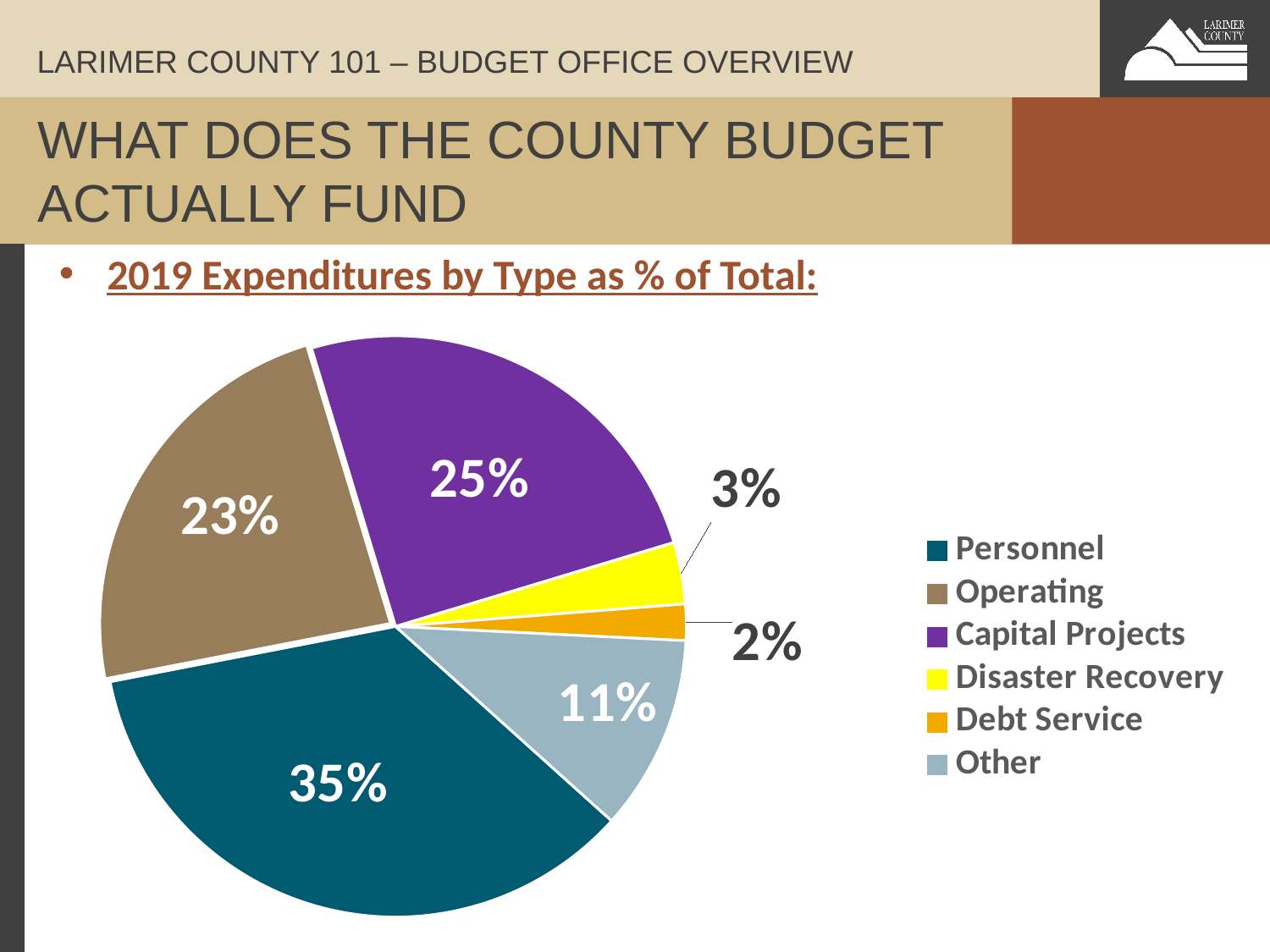
What share of 2019 expenditures is Personnel? 35% What share of 2019 expenditures is Capital Projects? 25% How many expenditure types are shown in the pie chart? 6 Which expenditure type has the largest share of the 2019 total? Personnel What share of 2019 expenditures is Operating? 23% What share of 2019 expenditures is Disaster Recovery? 3% Which is larger, the Capital Projects share or the Operating share? Capital Projects How many percentage points larger is the Personnel share than the Operating share? 12 What kind of chart is used to show 2019 expenditures by type? Pie chart What share of 2019 expenditures is Other? 11% What share of 2019 expenditures is Debt Service? 2% Which expenditure type has the smallest share of the 2019 total? Debt Service